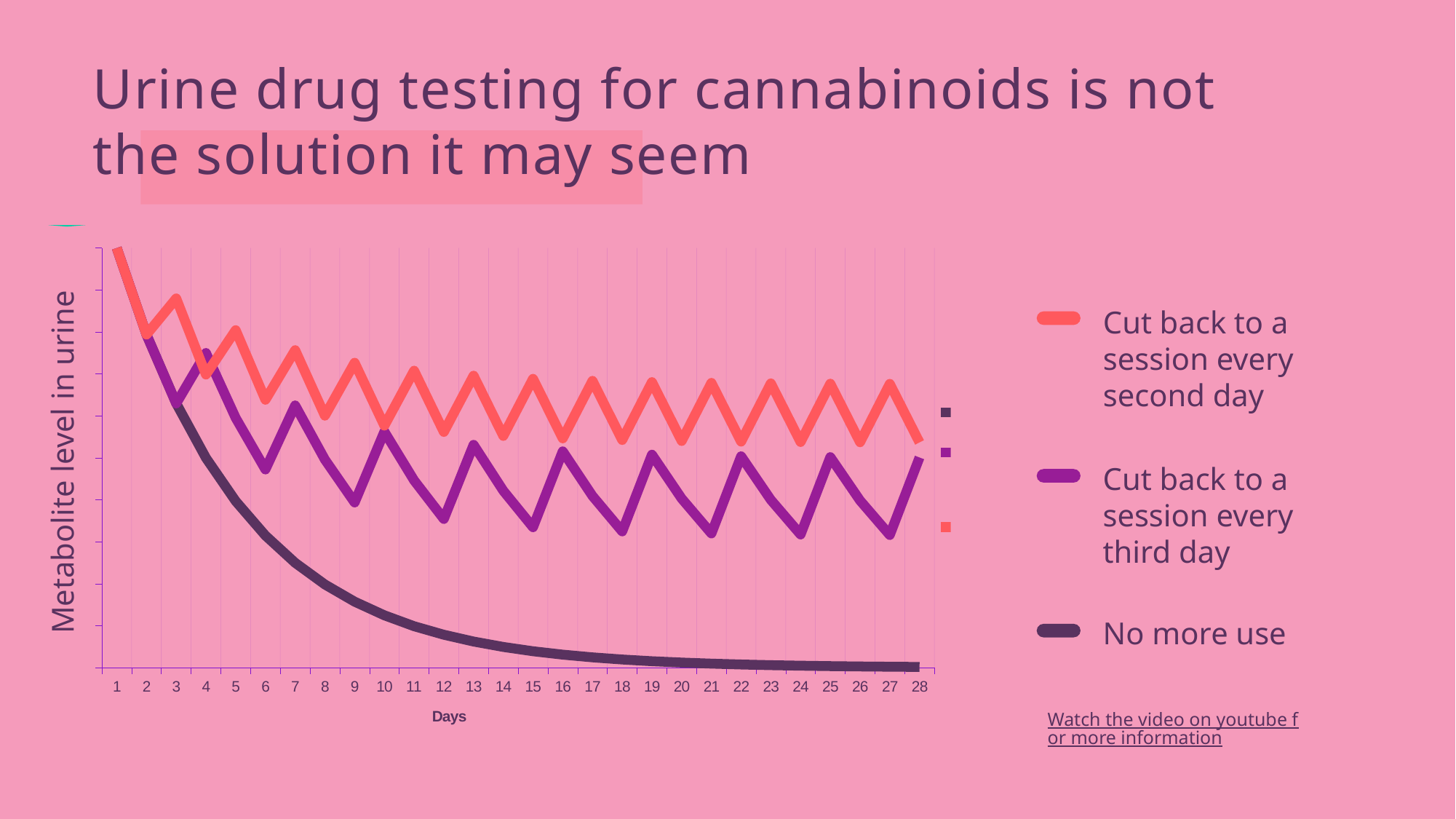
What kind of chart is shown on the slide? line chart Does the 'No more use' series rise or fall from day 1 to day 28? fall How many series does the legend list? 3 What is the label of the x axis? Days Which series has the lowest metabolite level at day 28? No more use At day 20, which series is higher: 'Cut back to a session every second day' or 'Cut back to a session every third day'? Cut back to a session every second day Which series has the highest metabolite level at day 28? Cut back to a session every second day At day 28, which series is higher: 'Cut back to a session every third day' or 'No more use'? Cut back to a session every third day What is the label of the y axis? Metabolite level in urine How many days are labelled along the x axis? 28 Which series shows a smooth decline without any peaks? No more use